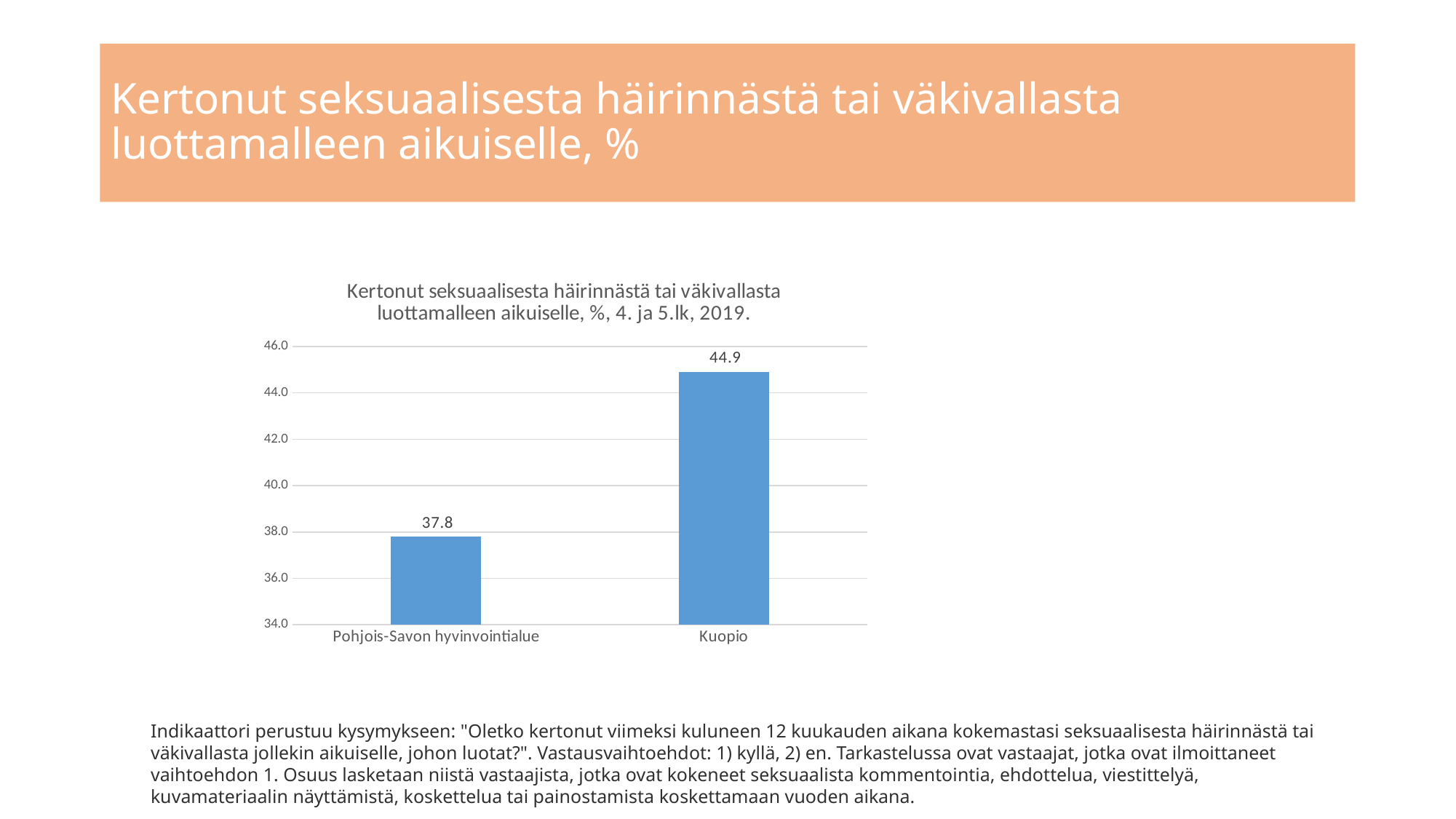
Is the value for Kuopio greater or less than 42.0? greater How many categories are shown on the x axis? 2 What is the difference between the values for Kuopio and Pohjois-Savon hyvinvointialue? 7.1 What is the title of the chart? Kertonut seksuaalisesta häirinnästä tai väkivallasta luottamalleen aikuiselle, %, 4. ja 5.lk, 2019. What kind of chart is shown on the slide? bar chart What is the value for Kuopio? 44.9 Which is larger, the value for Kuopio or the value for Pohjois-Savon hyvinvointialue? Kuopio Is the value for Pohjois-Savon hyvinvointialue greater or less than 40.0? less Which category has the highest value? Kuopio Which category has the lowest value? Pohjois-Savon hyvinvointialue What is the lowest value shown on the y axis? 34.0 What is the value for Pohjois-Savon hyvinvointialue? 37.8